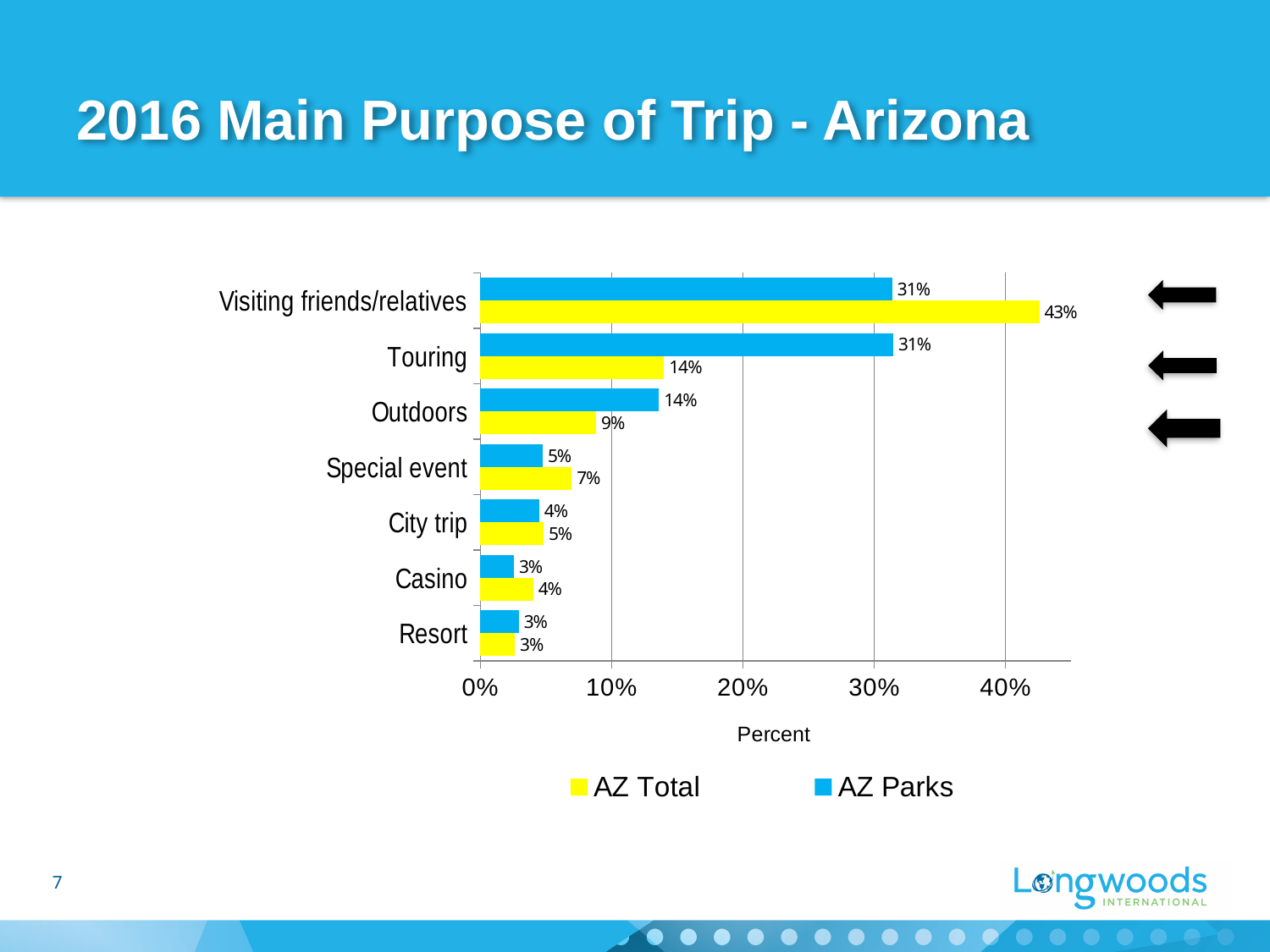
What is the AZ Total value for Outdoors? 9% What is the label on the horizontal axis of the chart? Percent What kind of chart is shown on the slide? Bar chart What is the AZ Parks value for Special event? 5% Which is larger for Outdoors, the AZ Parks value or the AZ Total value? AZ Parks What is the AZ Parks value for Touring? 31% Which category has the highest AZ Total value? Visiting friends/relatives How many series does the legend list? 2 What is the AZ Total value for Visiting friends/relatives? 43% How many trip purpose categories are shown on the chart? 7 What is the difference between the AZ Total and AZ Parks values for Touring? 17% Which category has the lowest AZ Total value? Resort